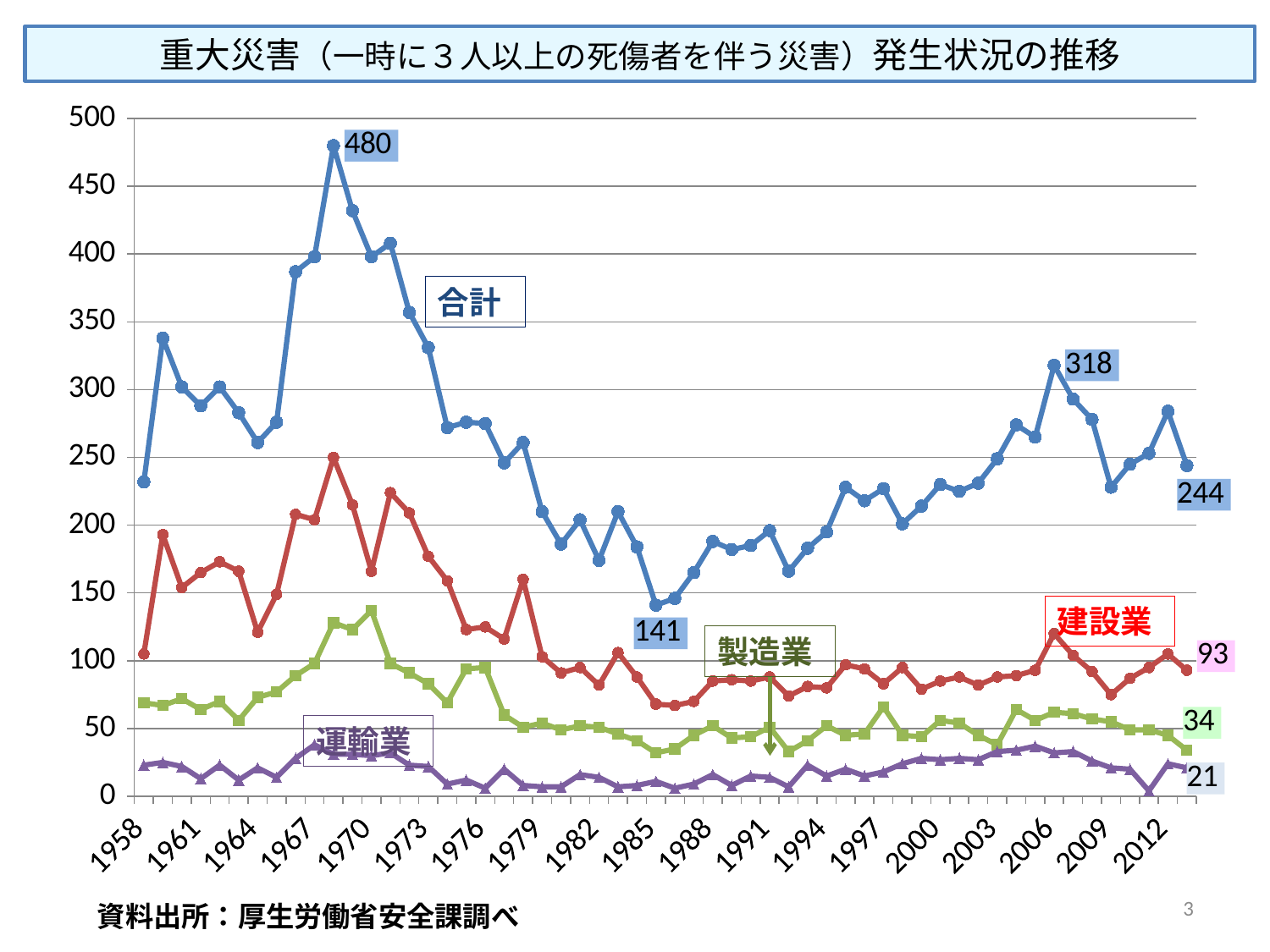
What kind of chart is shown on the slide? line chart What is the final labelled value of the 製造業 line? 34 What is the highest value labelled on the 合計 line? 480 What is the final labelled value of the 建設業 line? 93 What is the difference between the 480 peak and the 318 labelled value on the 合計 line? 162 What is the final (rightmost) labelled value of the 合計 line? 244 Is the 運輸業 value in 1958 greater or less than 50? less How many series (lines) are plotted on the chart? 4 What is the difference between the final labelled values of 建設業 (93) and 製造業 (34)? 59 At the right end of the chart, which is larger, the 建設業 value or the 製造業 value? 建設業 What is the final labelled value of the 運輸業 line? 21 What is the lowest value labelled on the 合計 line? 141